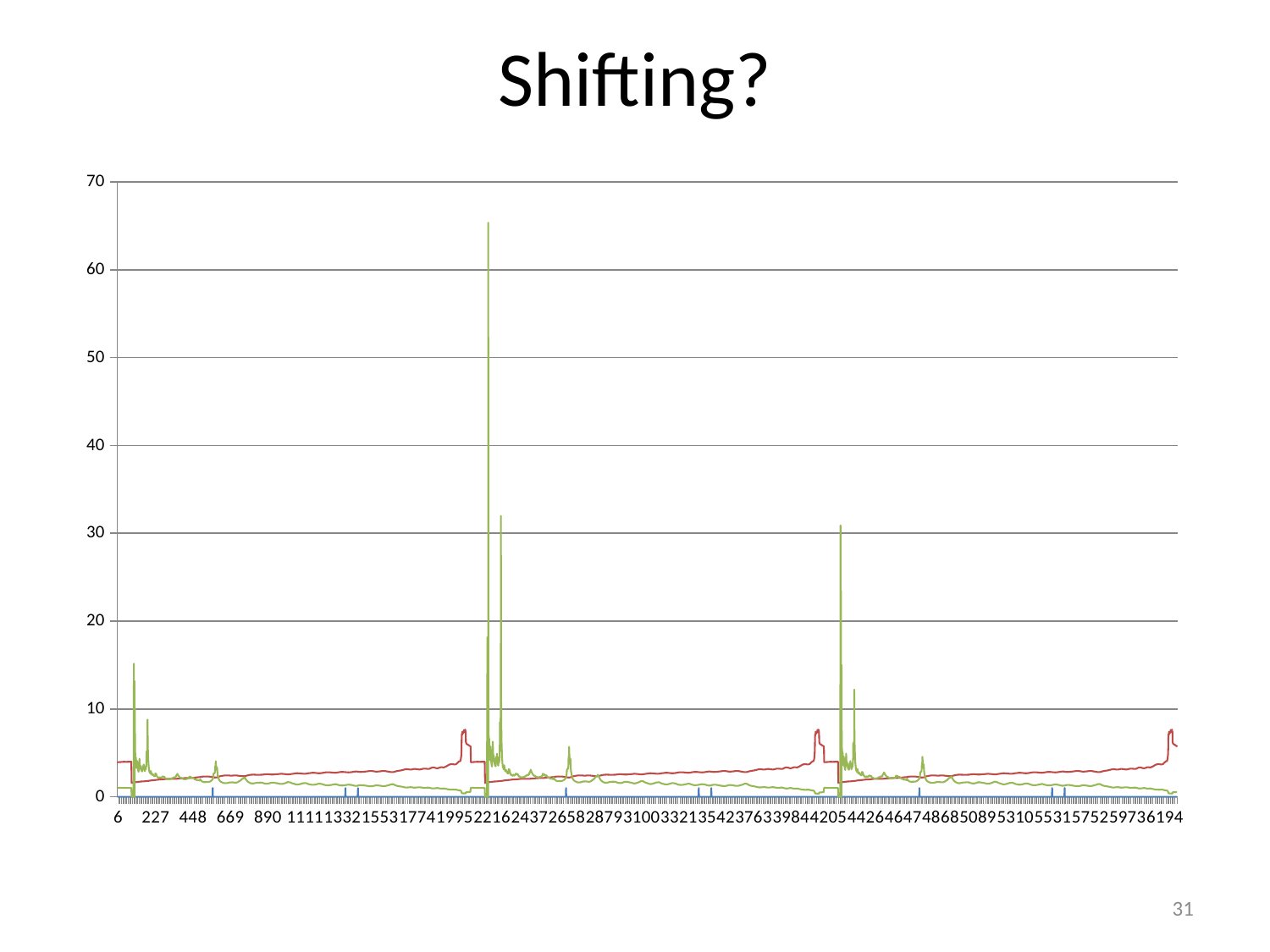
Is the highest value of the red line greater or less than 5? greater Is the highest peak of the green line greater or less than 60? greater What is the last label on the horizontal axis? 6194 Is the highest value of the red line greater or less than 10? less What is the highest value shown on the vertical axis? 70 Which line reaches a higher peak, the green line or the red line? green What kind of chart is shown on the slide? line chart Which colour is the line that reaches the highest peak on the chart? green What is the title of the chart on the slide? Shifting? What is the first label on the horizontal axis? 6